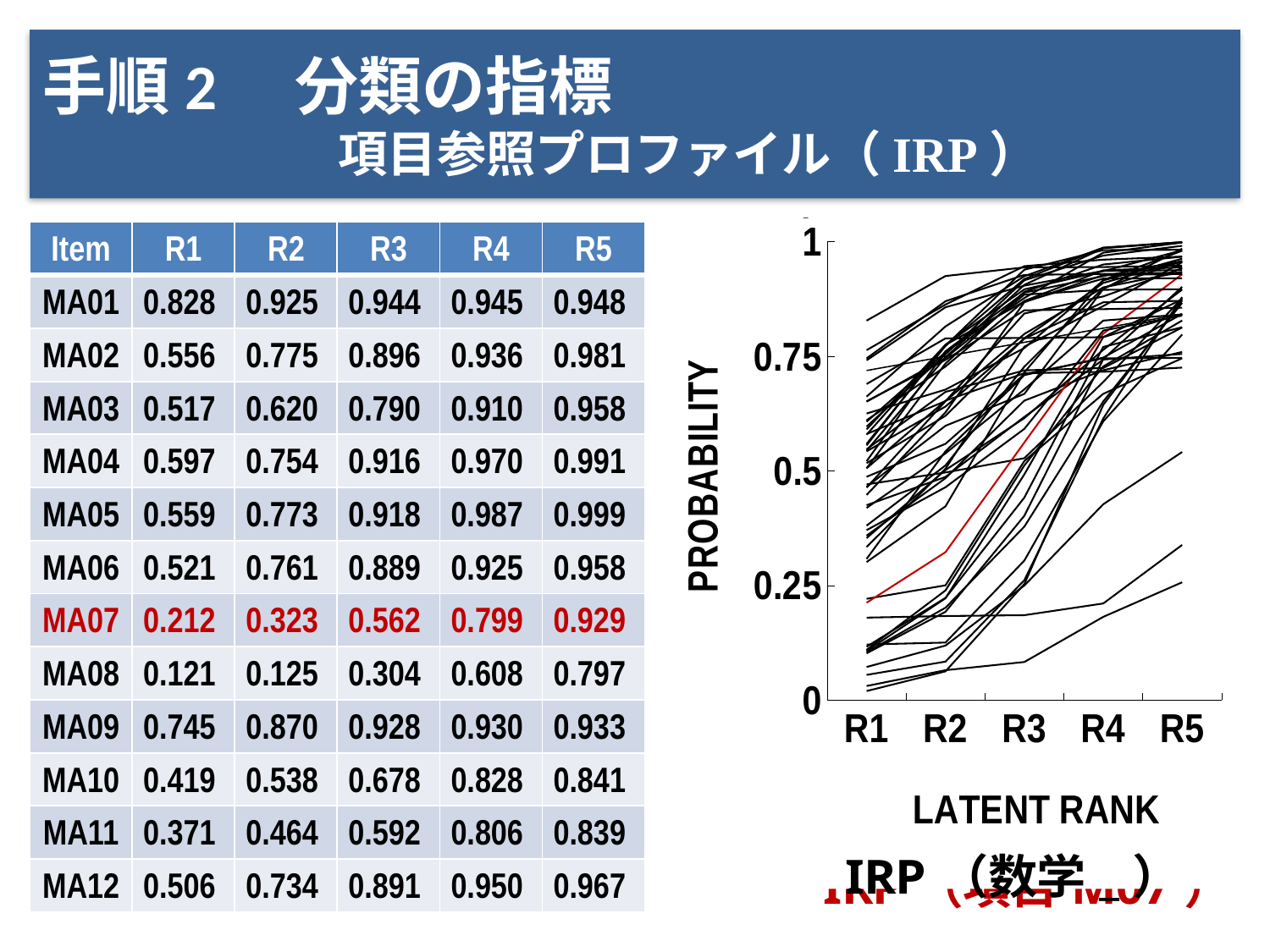
What kind of chart is shown on the right side of the slide? line chart Is the value of the red line at R1 greater or less than 0.25? less Is the value of the red line at R4 greater or less than 0.75? greater For the red line, is the value at R5 larger or smaller than the value at R1? larger Is the value of the red line at R5 greater or less than 0.75? greater How many latent rank categories are shown on the x axis of the chart? 5 At which latent rank does the red line reach its highest value? R5 What is the label of the y axis of the chart? PROBABILITY Do the lines in the chart generally rise or fall from R1 to R5? rise What is the label of the x axis of the chart? LATENT RANK